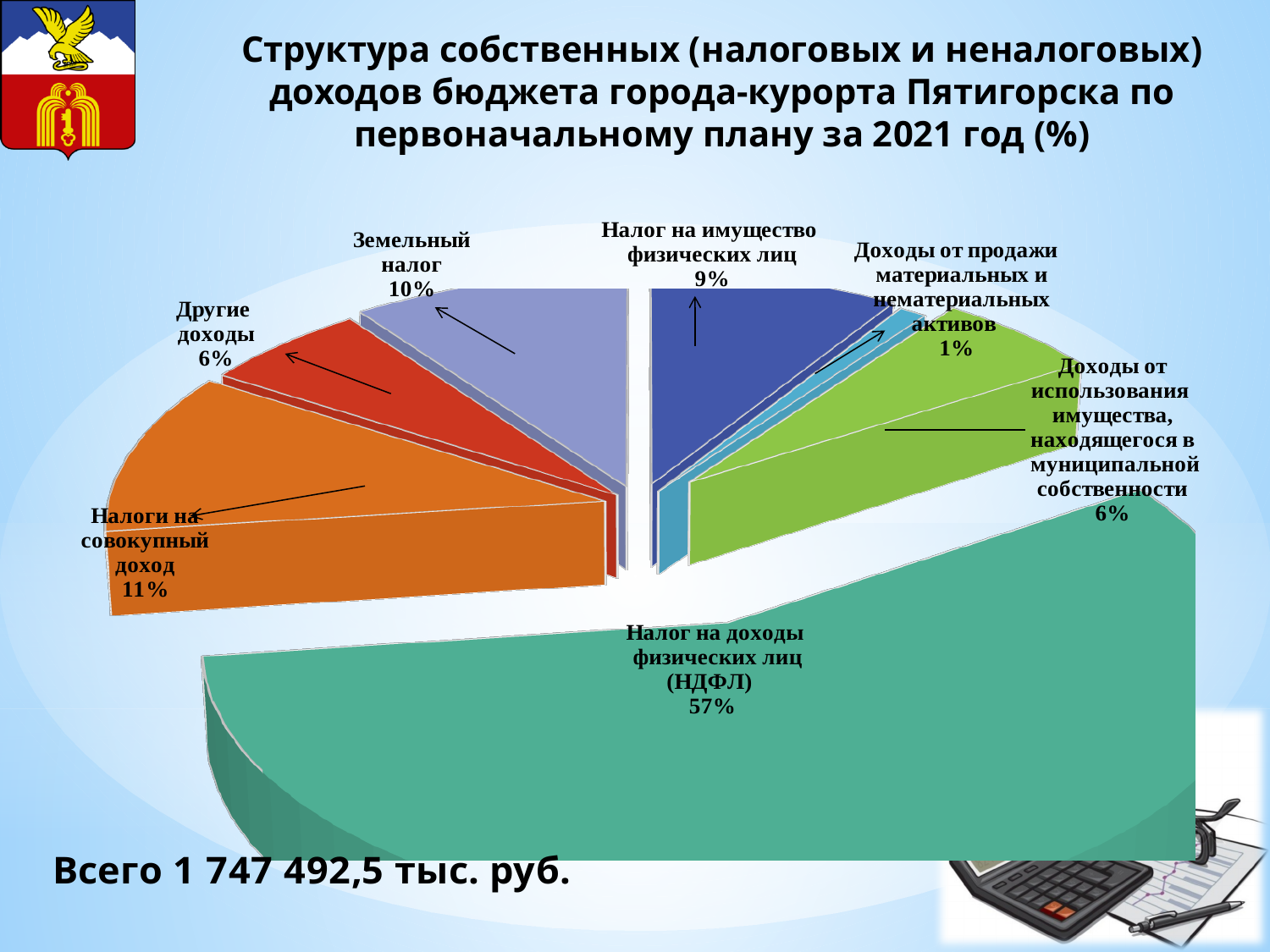
Сколько категорий показано на диаграмме? 7 Какая категория имеет наибольшую долю в структуре доходов? Налог на доходы физических лиц (НДФЛ) Какую долю составляют налоги на совокупный доход? 11% Какой тип диаграммы показан на слайде? Круговая диаграмма Какова общая сумма собственных доходов, указанная на слайде? 1 747 492,5 тыс. руб. Какую долю составляет налог на доходы физических лиц (НДФЛ)? 57% За какой год представлена структура доходов бюджета? 2021 Какая категория имеет наименьшую долю в структуре доходов? Доходы от продажи материальных и нематериальных активов Какую долю составляют доходы от продажи материальных и нематериальных активов? 1% Какую долю составляет земельный налог? 10% Что больше: доля налога на имущество физических лиц или доля других доходов? Налог на имущество физических лиц На сколько процентных пунктов доля налогов на совокупный доход больше доли земельного налога? 1%